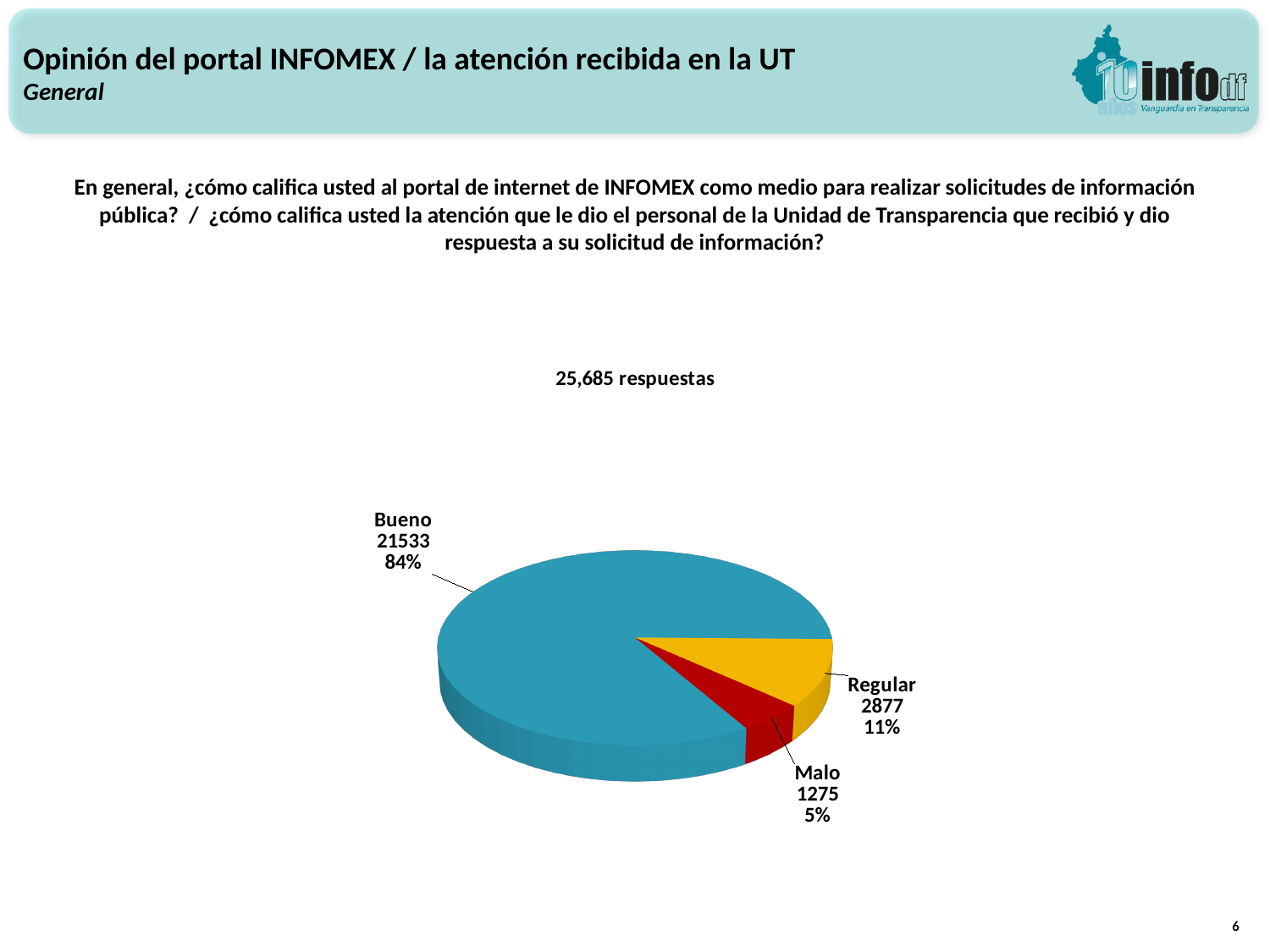
What is the difference in responses between Regular and Malo? 1602 What is the number of responses for Bueno? 21533 How many slices does the pie chart have? 3 Which category has the smallest slice? Malo Which has more responses, Regular or Malo? Regular What share of the pie does Malo represent? 5% What total number of responses is stated above the chart? 25,685 respuestas What share of the pie does Bueno represent? 84% What is the number of responses for Regular? 2877 What kind of chart is shown on the slide? pie chart What is the number of responses for Malo? 1275 Which category has the largest slice? Bueno